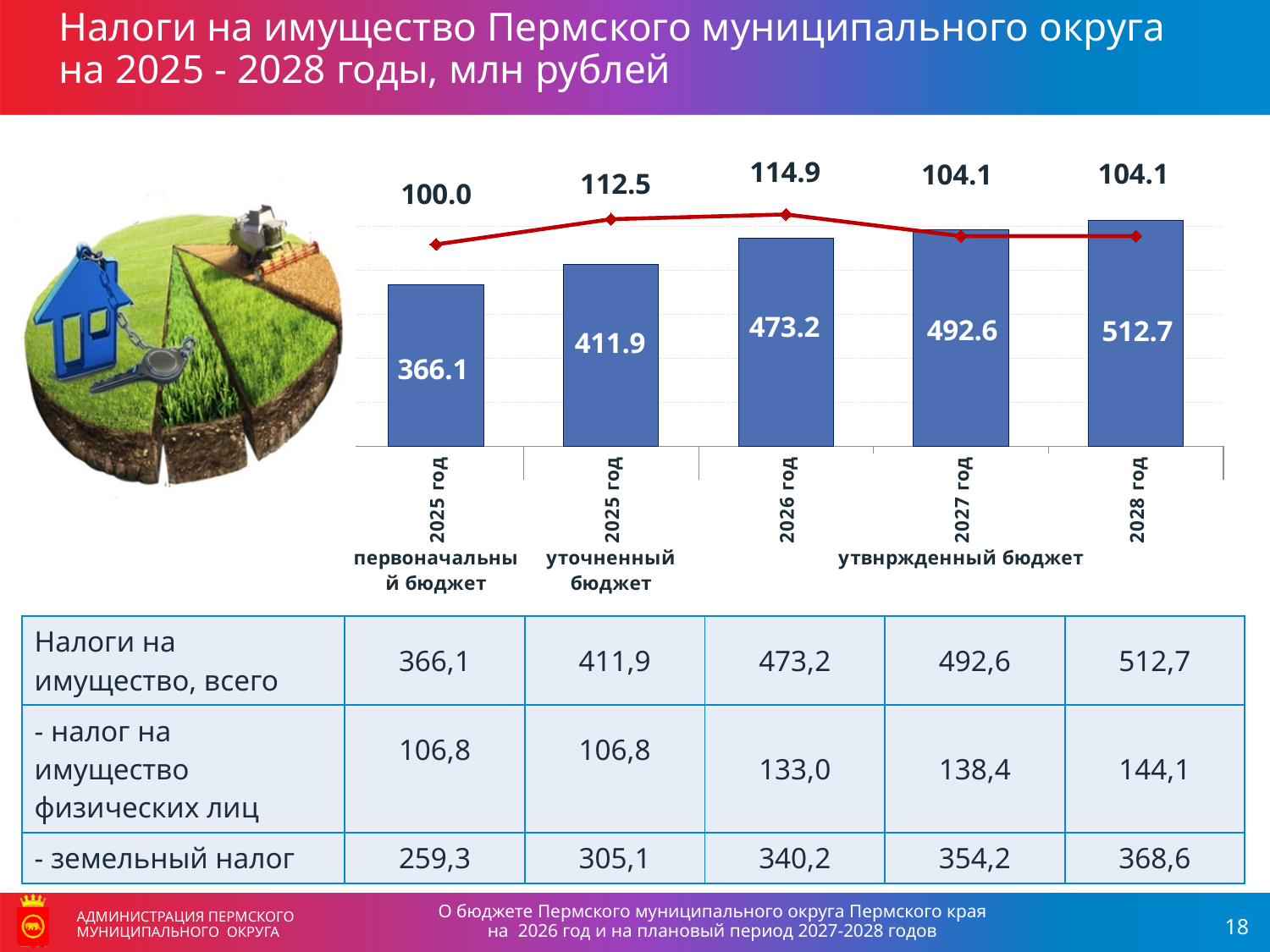
Which category has the lowest bar value? 2025 год (первоначальный бюджет) Do the bar values rise or fall from left to right along the x axis? Rise How many bars are plotted in the chart? 5 What is the line value shown above the bar for 2026 год? 114.9 What kind of chart is shown on the slide? Bar chart with a line Which is larger, the bar value for 2026 год or for 2025 год (уточненный бюджет)? 2026 год What is the line value shown above the bar for 2025 год (первоначальный бюджет)? 100.0 What is the value of the bar for 2026 год? 473.2 What is the value of the bar for 2025 год (уточненный бюджет)? 411.9 What is the difference between the bar values for 2028 год and 2027 год? 20.1 Which category has the highest bar value? 2028 год What is the value of the bar for 2028 год? 512.7